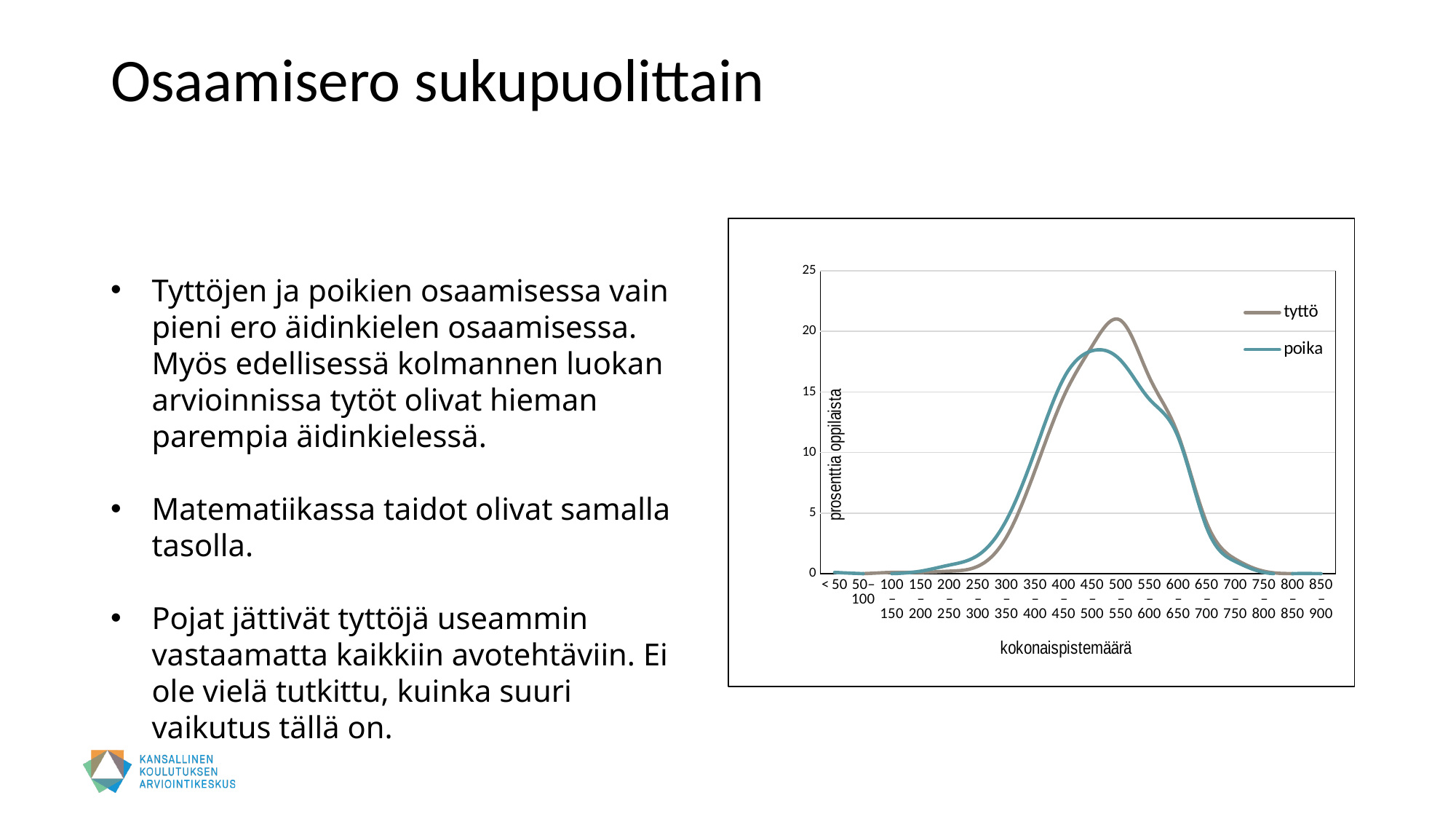
In the 500–550 category, which series has the higher value, tyttö or poika? tyttö In the 400–450 category, which series has the higher value, tyttö or poika? poika How many series does the legend list? 2 What is the label of the vertical axis? prosenttia oppilaista Which series reaches the higher peak value, tyttö or poika? tyttö Is the value for tyttö in the 300–350 category greater or less than 10? less What are the two series named in the legend? tyttö and poika Is the peak value of the tyttö line greater or less than 20? greater Is the peak value of the poika line greater or less than 20? less How many score categories are shown along the x axis? 18 In which score category does the tyttö line reach its highest value? 500–550 What kind of chart is shown on the slide? line chart